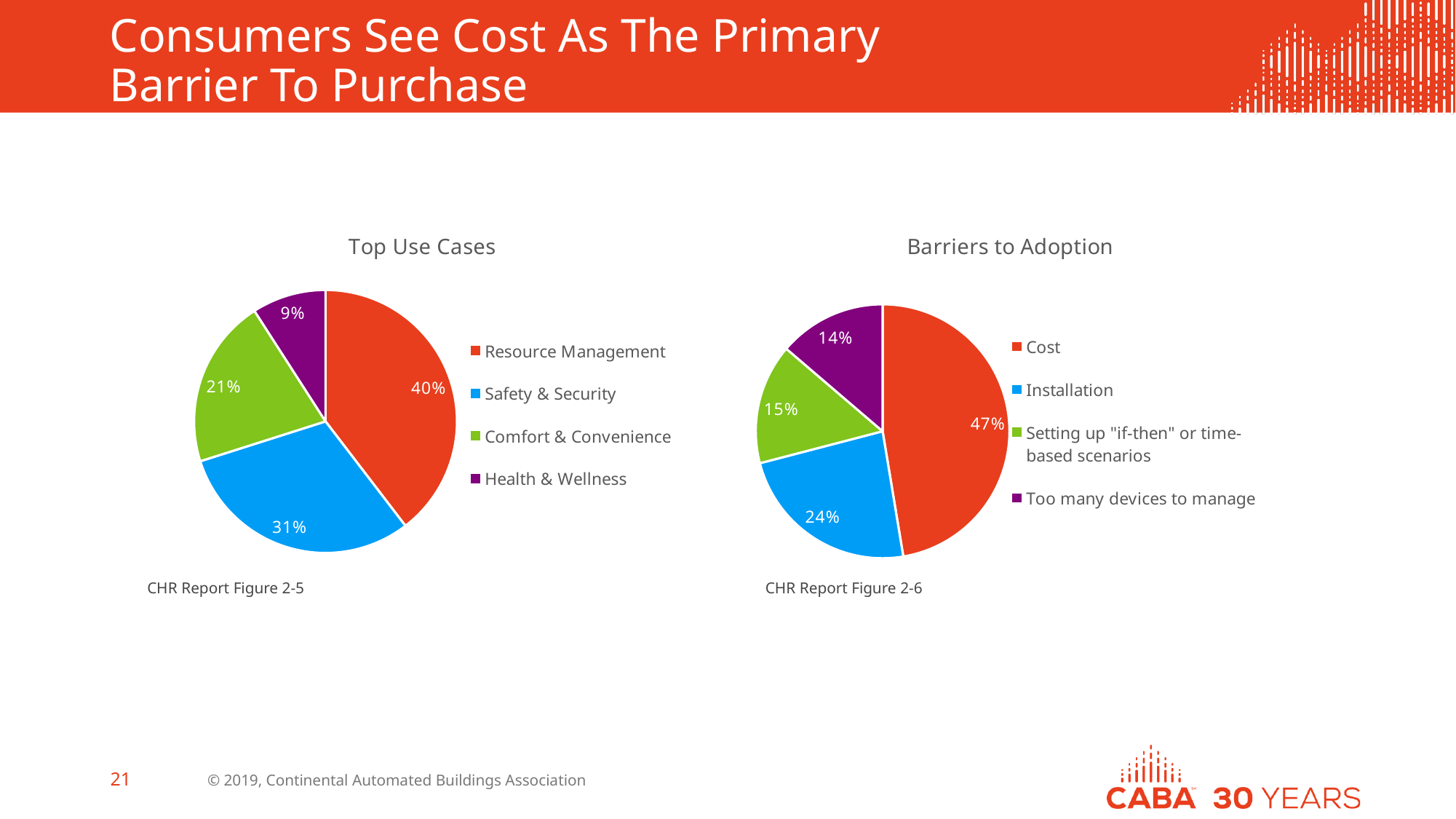
What kind of chart is the 'Barriers to Adoption' chart? Pie chart In the 'Barriers to Adoption' chart, which is larger: Installation or 'Setting up "if-then" or time-based scenarios'? Installation In the 'Barriers to Adoption' chart, which category has the largest slice? Cost In the 'Top Use Cases' chart, how many categories are shown? 4 In the 'Top Use Cases' chart, which category has the smallest slice? Health & Wellness In the 'Top Use Cases' chart, what share does Resource Management have? 40% In the 'Barriers to Adoption' chart, what is the difference between the Cost and Installation shares? 23% In the 'Top Use Cases' chart, what colour is the Safety & Security slice? Blue In the 'Barriers to Adoption' chart, what share does Installation have? 24% In the 'Top Use Cases' chart, what is the difference between the Resource Management and Safety & Security shares? 9% In the 'Top Use Cases' chart, what share does Comfort & Convenience have? 21% In the 'Barriers to Adoption' chart, what share does 'Too many devices to manage' have? 14%